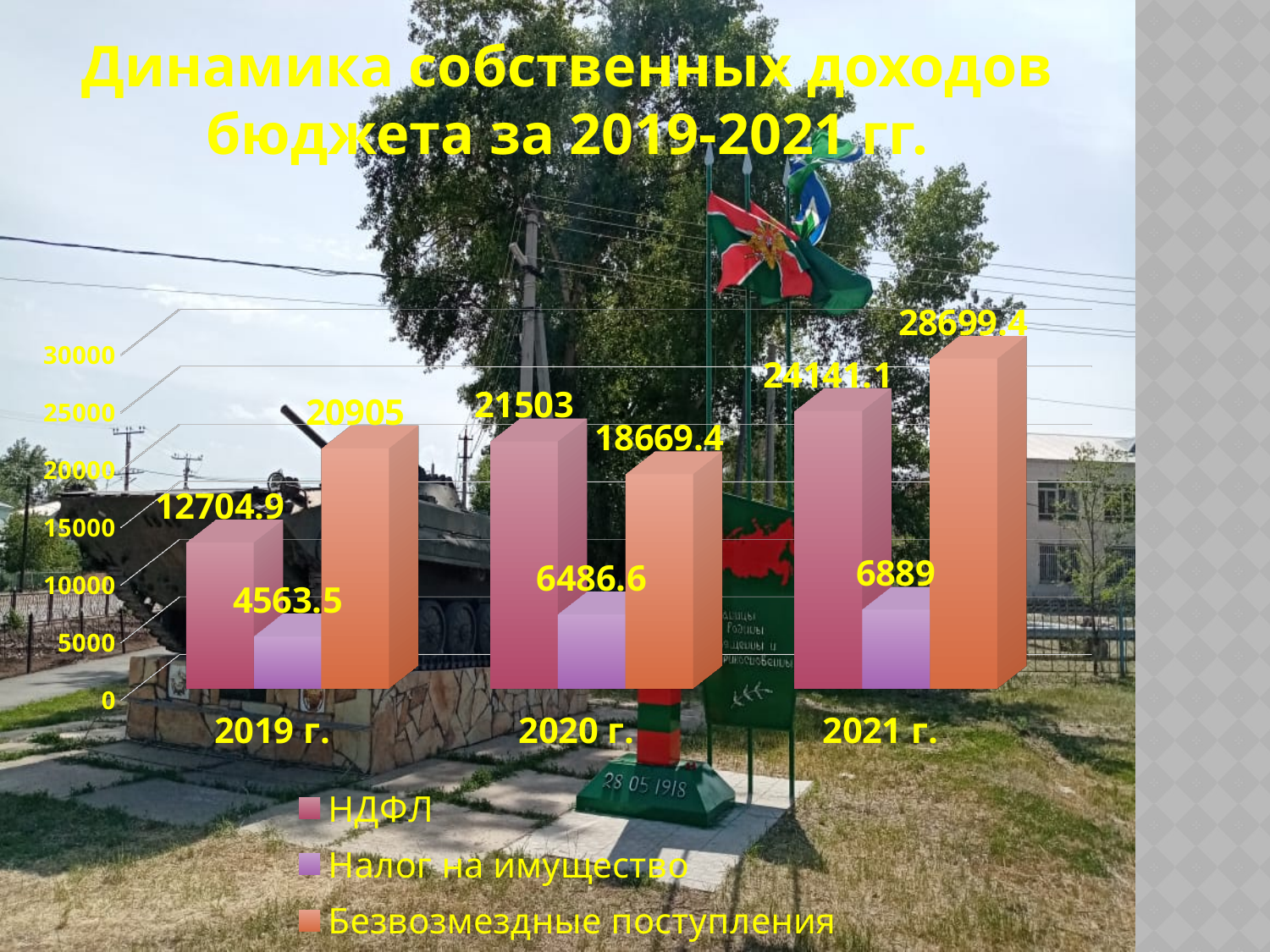
What is the difference between НДФЛ in 2020 г. and НДФЛ in 2019 г.? 8798.1 In which year is НДФЛ the highest? 2021 г. What is the value of Безвозмездные поступления for 2020 г.? 18669.4 Which is larger in 2020 г.: НДФЛ or Безвозмездные поступления? НДФЛ What is the value of Безвозмездные поступления for 2021 г.? 28699.4 What kind of chart is shown on the slide? Bar chart How many series does the legend list? 3 Does the value of НДФЛ rise or fall from 2019 г. to 2021 г.? Rises In which year is Налог на имущество the lowest? 2019 г. How many years are shown on the x axis? 3 What is the value of НДФЛ for 2019 г.? 12704.9 What is the value of Налог на имущество for 2020 г.? 6486.6